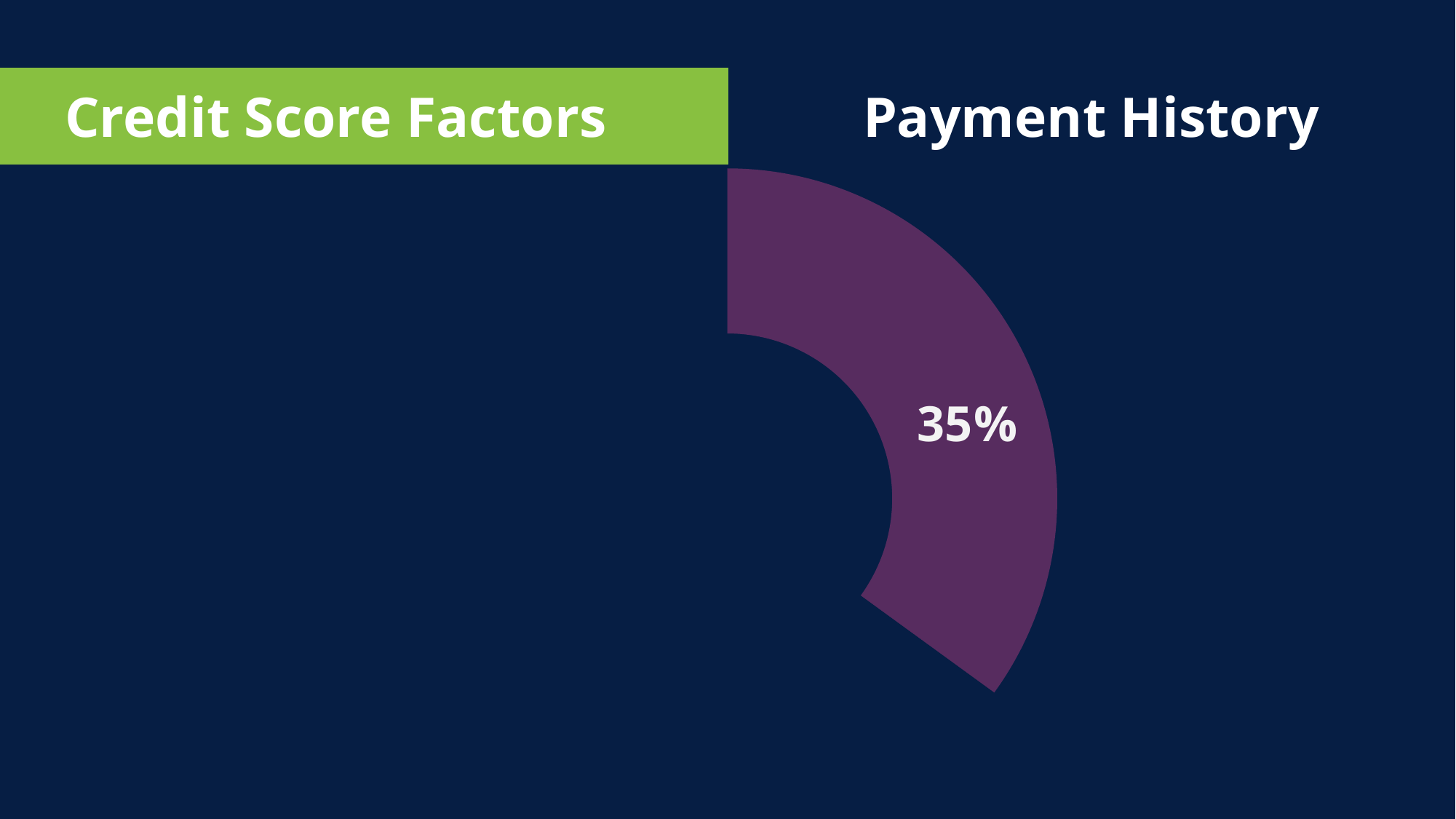
What is the value shown for Payment History? 35% What is the title of the chart? Credit Score Factors What share of the chart does the Payment History slice represent? 35% Which credit score factor is labelled on the slide? Payment History What kind of chart is shown on the slide? Doughnut chart How many slices are visible in the chart? 1